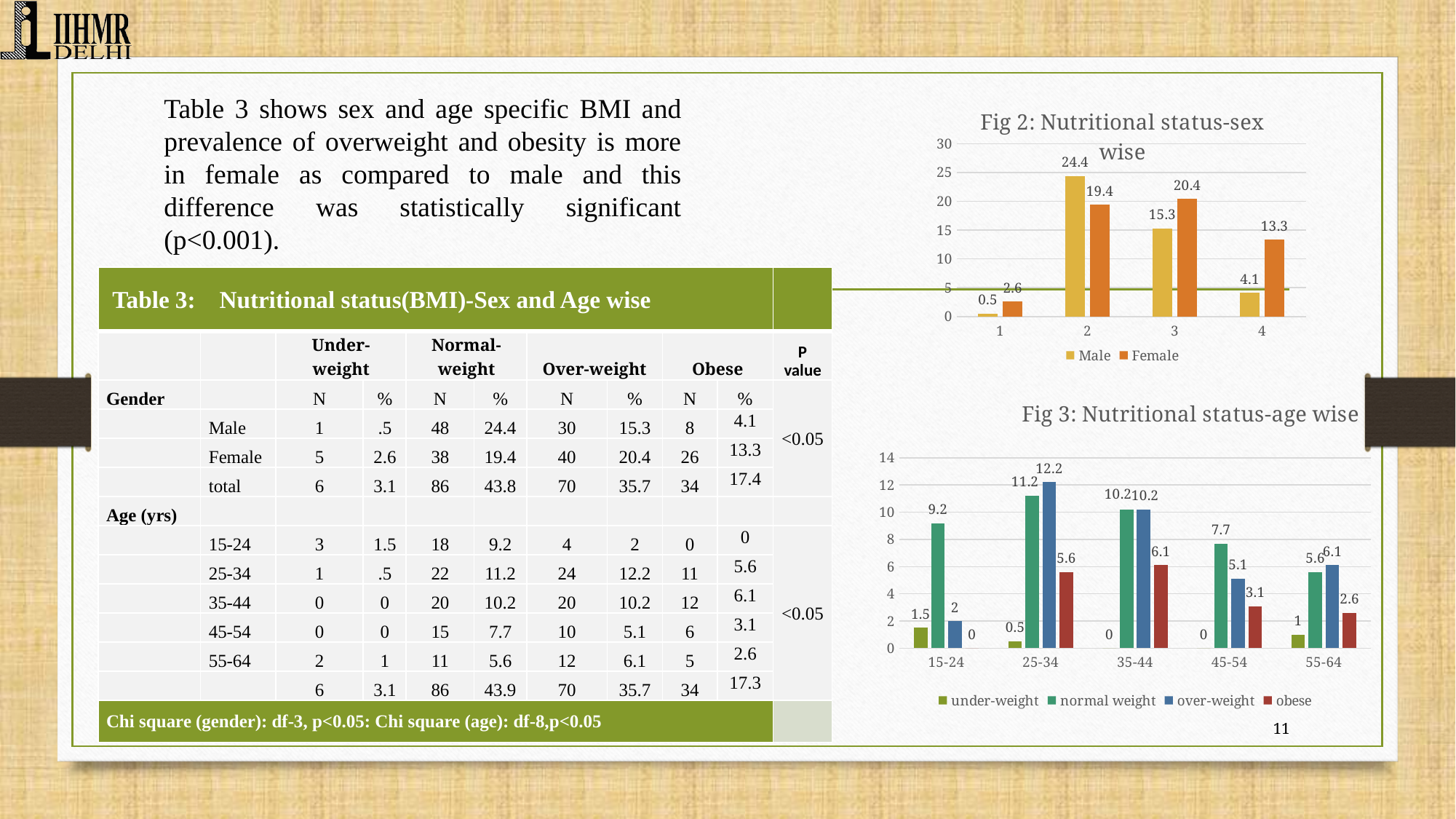
In the chart titled 'Fig 2: Nutritional status-sex wise', which category has the lowest Male value? 1 In the chart titled 'Fig 3: Nutritional status-age wise', which age group has the highest normal weight value? 25-34 In the chart titled 'Fig 2: Nutritional status-sex wise', what is the Female value for category 4? 13.3 In the chart titled 'Fig 3: Nutritional status-age wise', how many series does the legend list? 4 In the chart titled 'Fig 3: Nutritional status-age wise', what is the over-weight value for the 25-34 age group? 12.2 In the chart titled 'Fig 2: Nutritional status-sex wise', how many series does the legend list? 2 In the chart titled 'Fig 3: Nutritional status-age wise', is the obese value for 35-44 larger or the obese value for 45-54? 35-44 In the chart titled 'Fig 3: Nutritional status-age wise', how many age groups are shown on the x axis? 5 In the chart titled 'Fig 2: Nutritional status-sex wise', what is the Male value for category 2? 24.4 What kind of chart is 'Fig 3: Nutritional status-age wise'? bar chart In the chart titled 'Fig 3: Nutritional status-age wise', what is the difference between the normal weight and over-weight values for the 55-64 age group? 0.5 In the chart titled 'Fig 2: Nutritional status-sex wise', what is the difference between the Female and Male values for category 3? 5.1